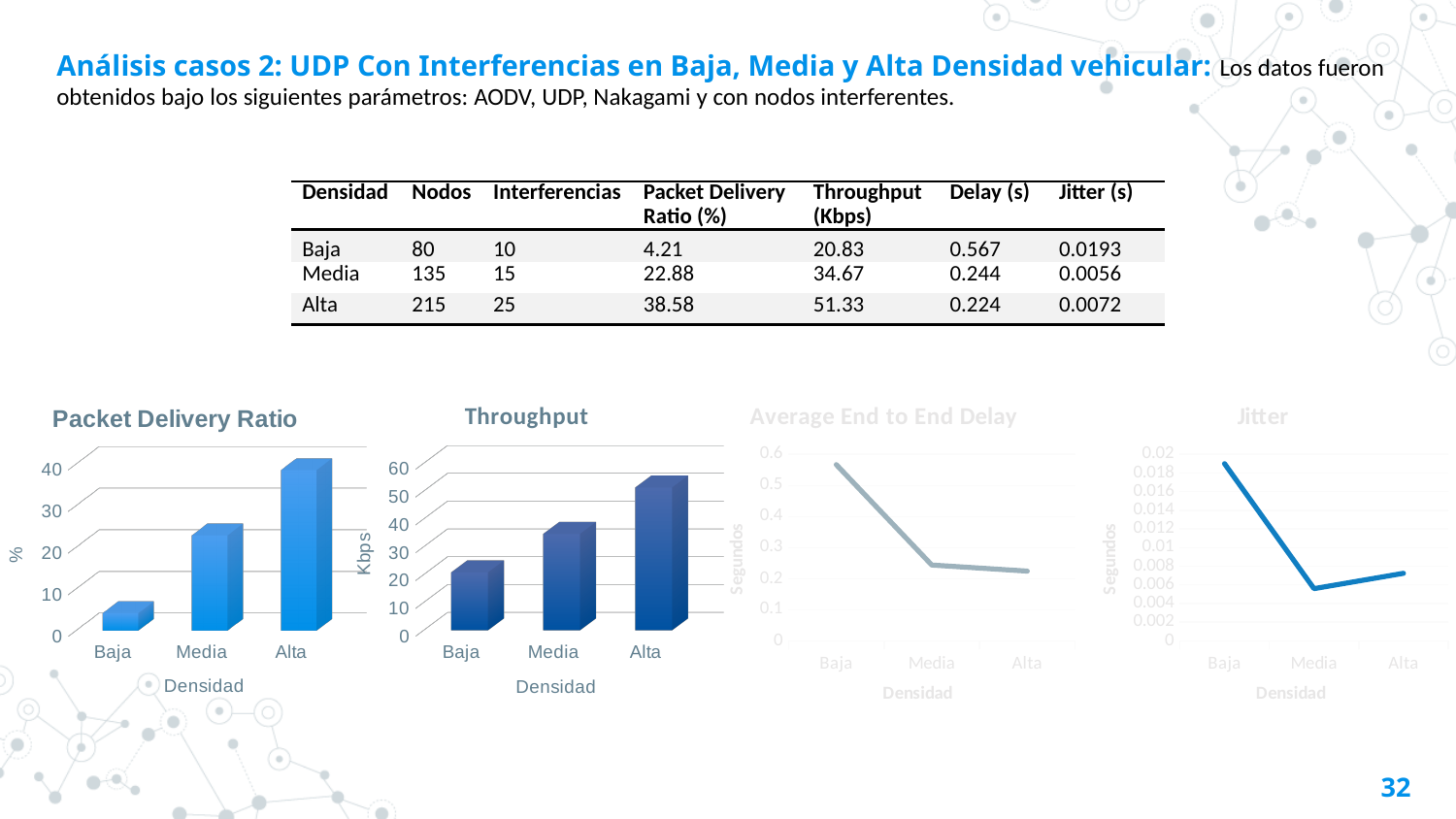
In the Throughput chart, do the values rise or fall from Baja to Alta? rise What is the y-axis label of the Throughput chart? Kbps In the Packet Delivery Ratio chart, which density has the highest value? Alta In the Average End to End Delay chart, which density has the highest delay? Baja In the Jitter chart, is the value for Media greater or less than 0.008? less How many density categories are shown on the x axis of the Jitter chart? 3 In the Throughput chart, is the value for Alta greater or less than 40? greater In the Packet Delivery Ratio chart, which density has the lowest value? Baja What kind of chart is the Throughput chart? bar chart In the Throughput chart, which is larger, the value for Media or the value for Baja? Media In the Packet Delivery Ratio chart, is the value for Baja greater or less than 10? less